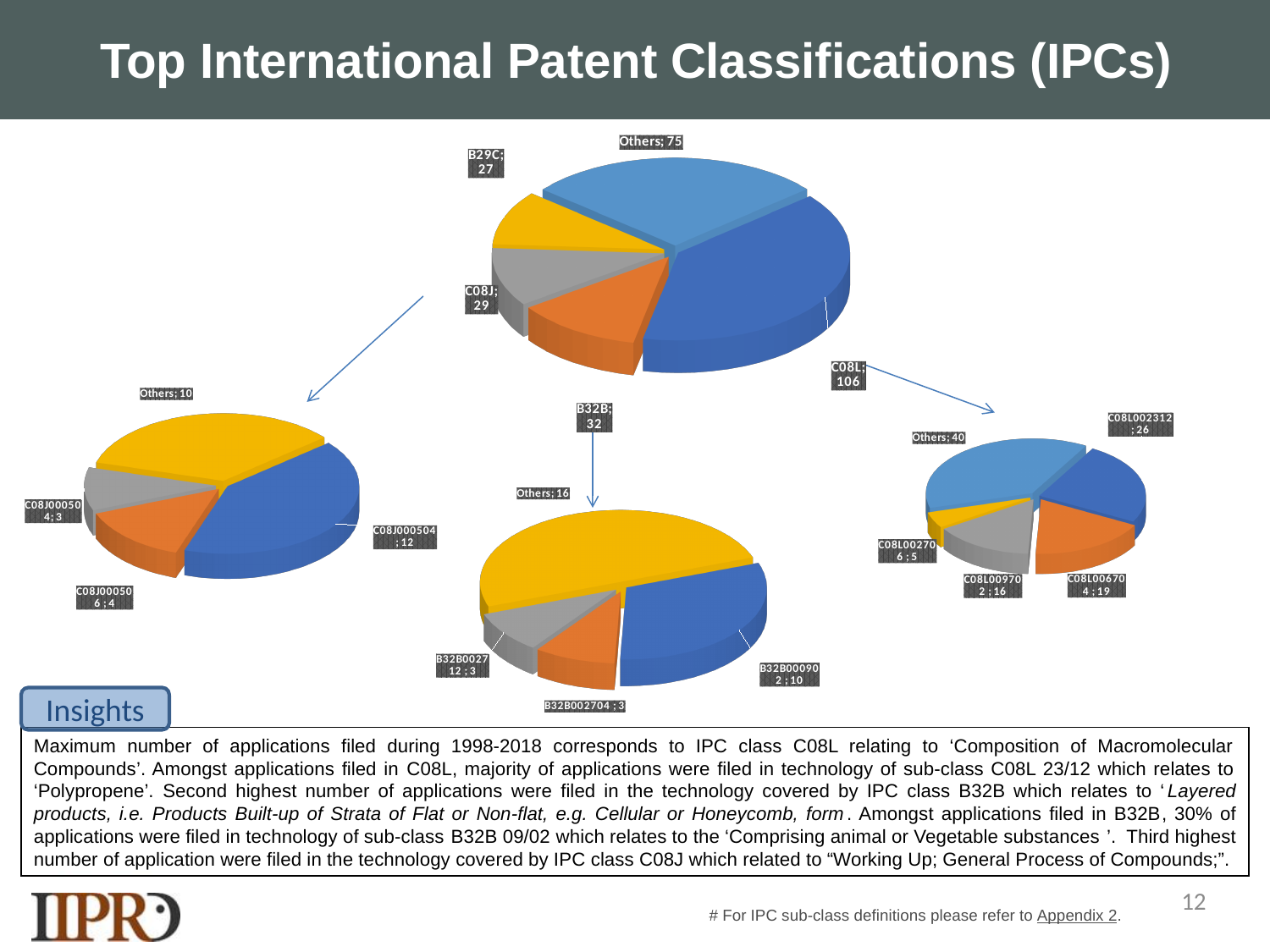
In the top-centre pie chart, which category has the highest value? C08L In the top-centre pie chart, which category has the lowest value? B29C In the top-centre pie chart, what is the value for B32B? 32 In the bottom-right pie chart, what is the value for Others? 40 In the bottom-centre pie chart, what is the value for Others? 16 How many slices does the top-centre pie chart have? 5 In the top-centre pie chart, what is the value for C08L? 106 In the top-centre pie chart, which is larger, C08J or B29C? C08J In the top-centre pie chart, what is the difference between the values for C08L and B32B? 74 What kind of chart is the large chart at the top centre of the slide? Pie chart How many pie charts are shown on the slide? 4 In the bottom-right pie chart, what is the value for C08L002312? 26